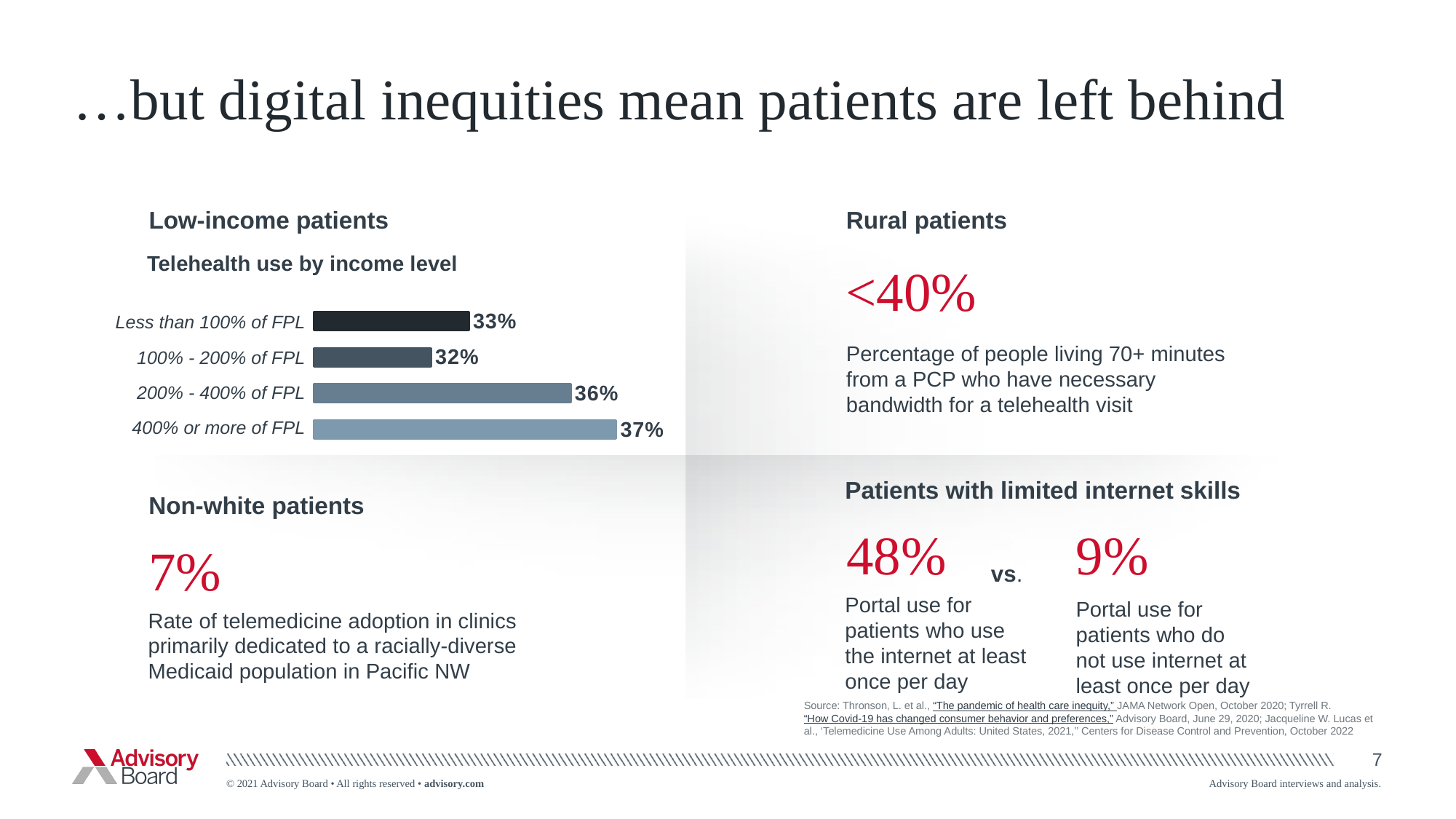
What type of chart is 'Telehealth use by income level'? Bar chart In the 'Telehealth use by income level' chart, what is the difference between the values for '200% - 400% of FPL' and 'Less than 100% of FPL'? 3% In the 'Telehealth use by income level' chart, what is the value for '100% - 200% of FPL'? 32% In the 'Telehealth use by income level' chart, which is larger: the value for '200% - 400% of FPL' or the value for 'Less than 100% of FPL'? 200% - 400% of FPL In the 'Telehealth use by income level' chart, what is the value for '200% - 400% of FPL'? 36% In the 'Telehealth use by income level' chart, what is the value for 'Less than 100% of FPL'? 33% How many income-level categories are shown in the 'Telehealth use by income level' chart? 4 In the 'Telehealth use by income level' chart, what is the value for '400% or more of FPL'? 37% What is the title of the bar chart under the 'Low-income patients' heading? Telehealth use by income level In the 'Telehealth use by income level' chart, what is the difference between the values for '400% or more of FPL' and '100% - 200% of FPL'? 5% In the 'Telehealth use by income level' chart, which income level has the lowest telehealth use? 100% - 200% of FPL In the 'Telehealth use by income level' chart, which income level has the highest telehealth use? 400% or more of FPL